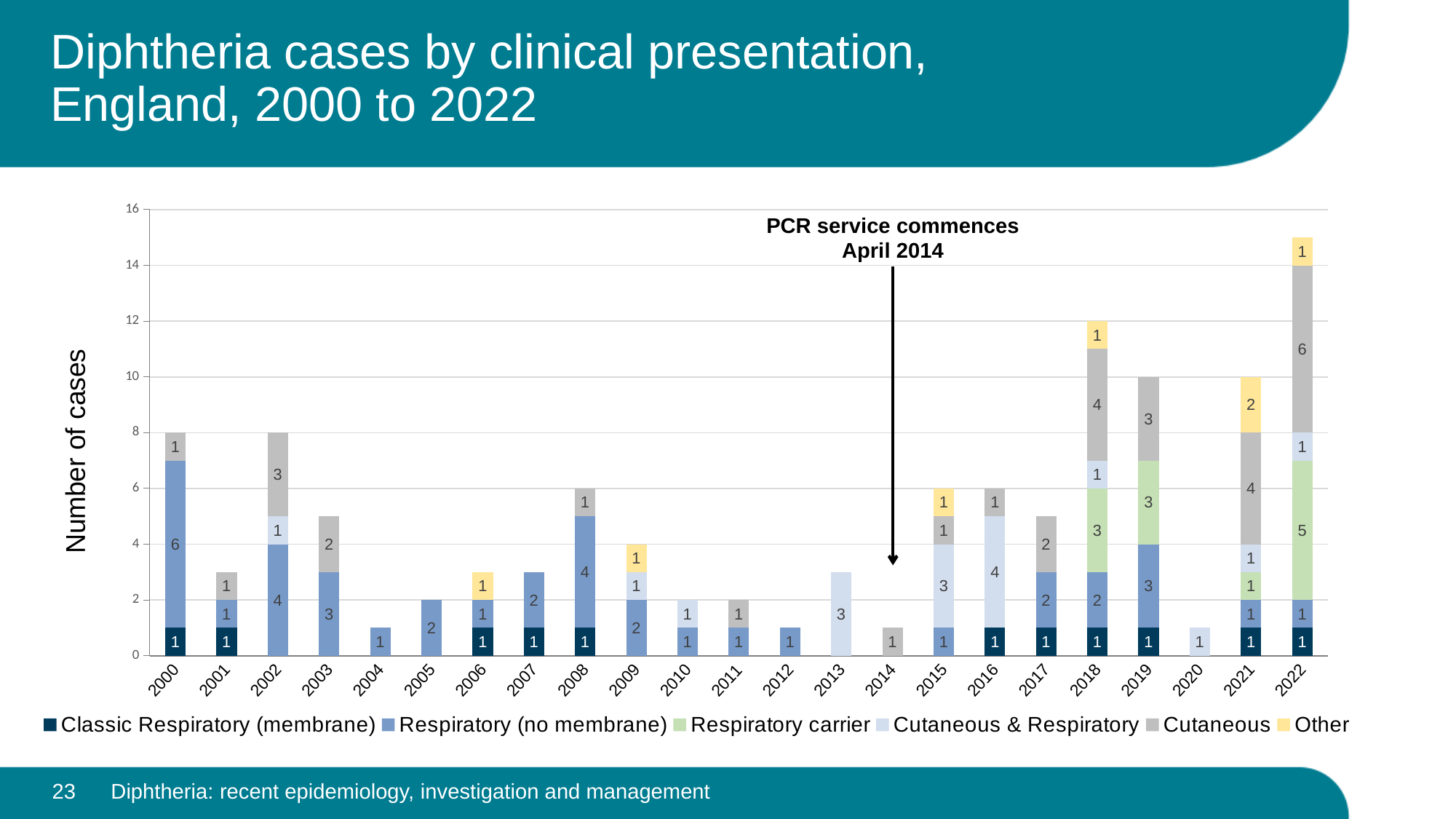
What type of chart is shown on the slide? Stacked bar chart What is the difference between the Cutaneous value in 2022 and the Cutaneous value in 2018? 2 What is the value for Respiratory carrier in 2019? 3 What event does the annotation arrow on the chart mark? PCR service commences April 2014 Which year has the highest total number of cases? 2022 Which is larger, the Respiratory carrier value in 2022 or the Respiratory carrier value in 2021? 2022 How many years are shown on the x axis? 23 What is the total number of cases in 2022? 15 What is the value for Respiratory (no membrane) in 2000? 6 What is the value for Cutaneous in 2022? 6 How many series does the legend list? 6 What is the total number of cases in 2018? 12